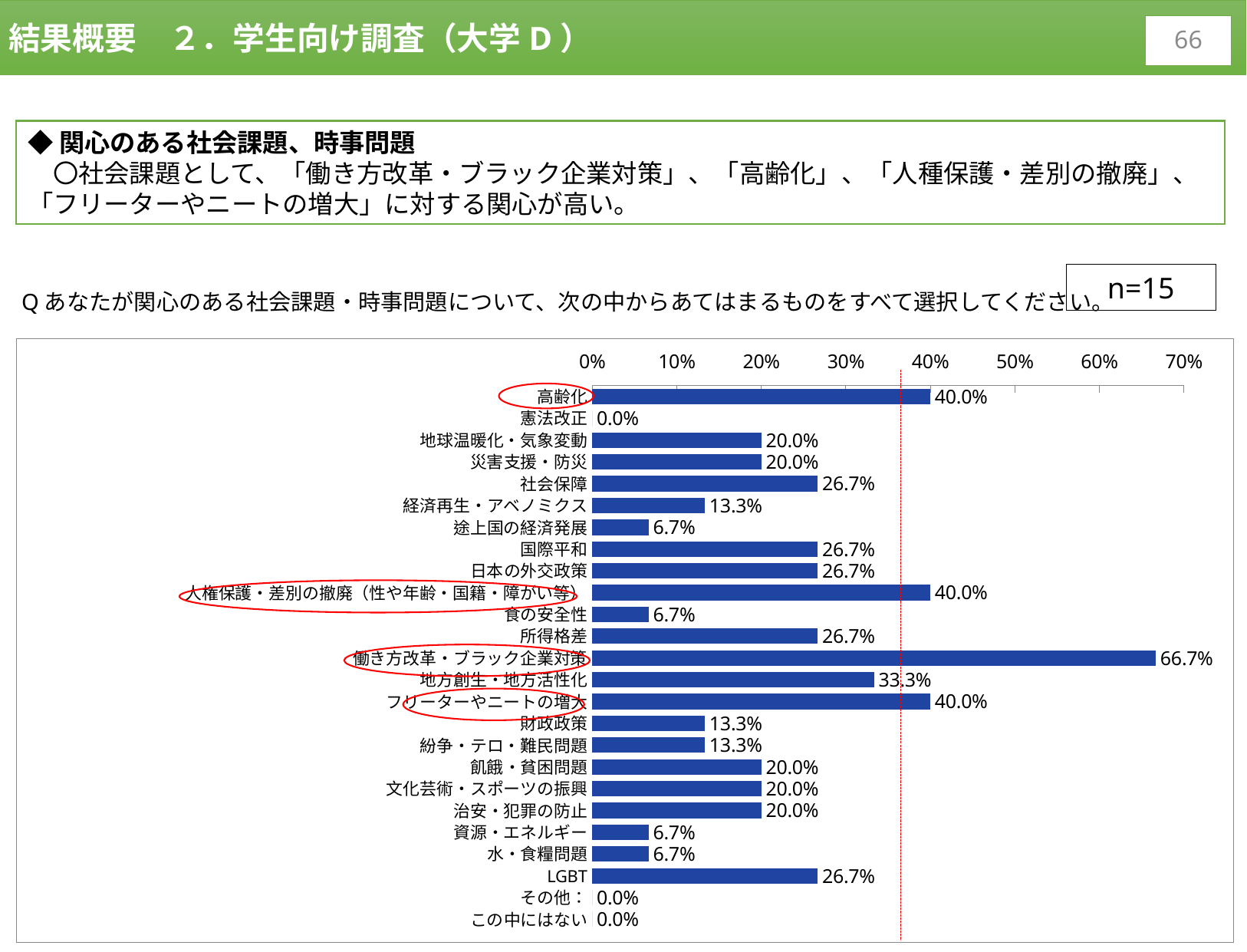
What is the sample size (n) shown on the slide? n=15 What is the value for 地方創生・地方活性化? 33.3% How many categories have a value of 0.0%? 3 How many categories are shown in the chart? 25 What is the value for 高齢化? 40.0% What is the difference between the values for 社会保障 and 途上国の経済発展? 20.0% What is the value for 働き方改革・ブラック企業対策? 66.7% Which category has the highest value? 働き方改革・ブラック企業対策 What is the value for 経済再生・アベノミクス? 13.3% Which is larger, the value for 地方創生・地方活性化 or the value for LGBT? 地方創生・地方活性化 What kind of chart is shown on the slide? bar chart What is the difference between the values for 働き方改革・ブラック企業対策 and フリーターやニートの増大? 26.7%